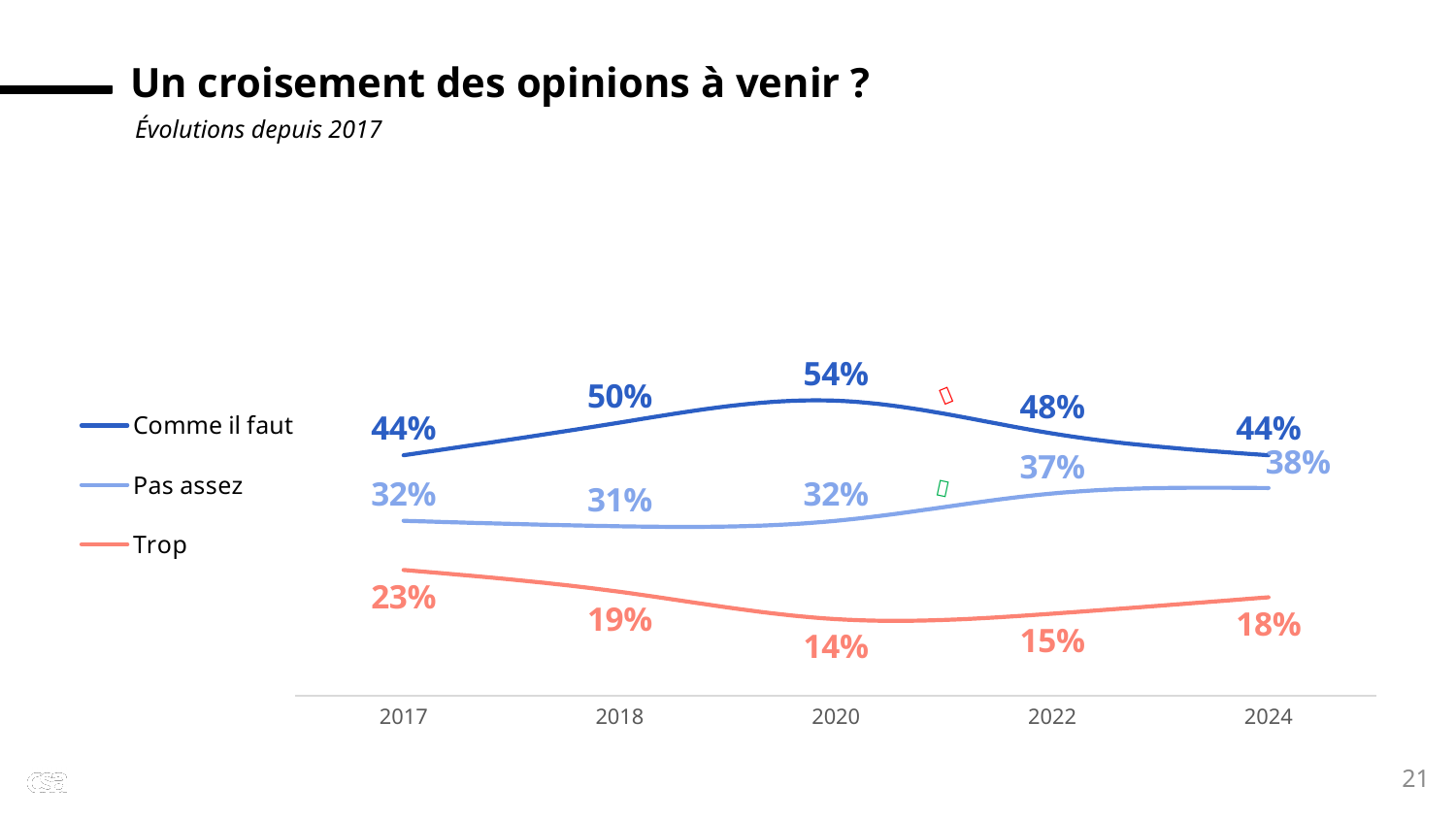
How many years are shown on the x axis? 5 What is the value for "Trop" in 2017? 23% In which year does the "Trop" series reach its lowest value? 2020 What is the value for "Pas assez" in 2024? 38% Which is larger in 2022: "Pas assez" or "Trop"? Pas assez What kind of chart is shown on the slide? Line chart How many series does the legend list? 3 What is the difference between "Comme il faut" and "Pas assez" in 2024? 6% In which year does the "Comme il faut" series reach its highest value? 2020 What is the title of the slide? Un croisement des opinions à venir ? Does the "Pas assez" series rise or fall between 2020 and 2024? Rise What is the value for "Comme il faut" in 2020? 54%